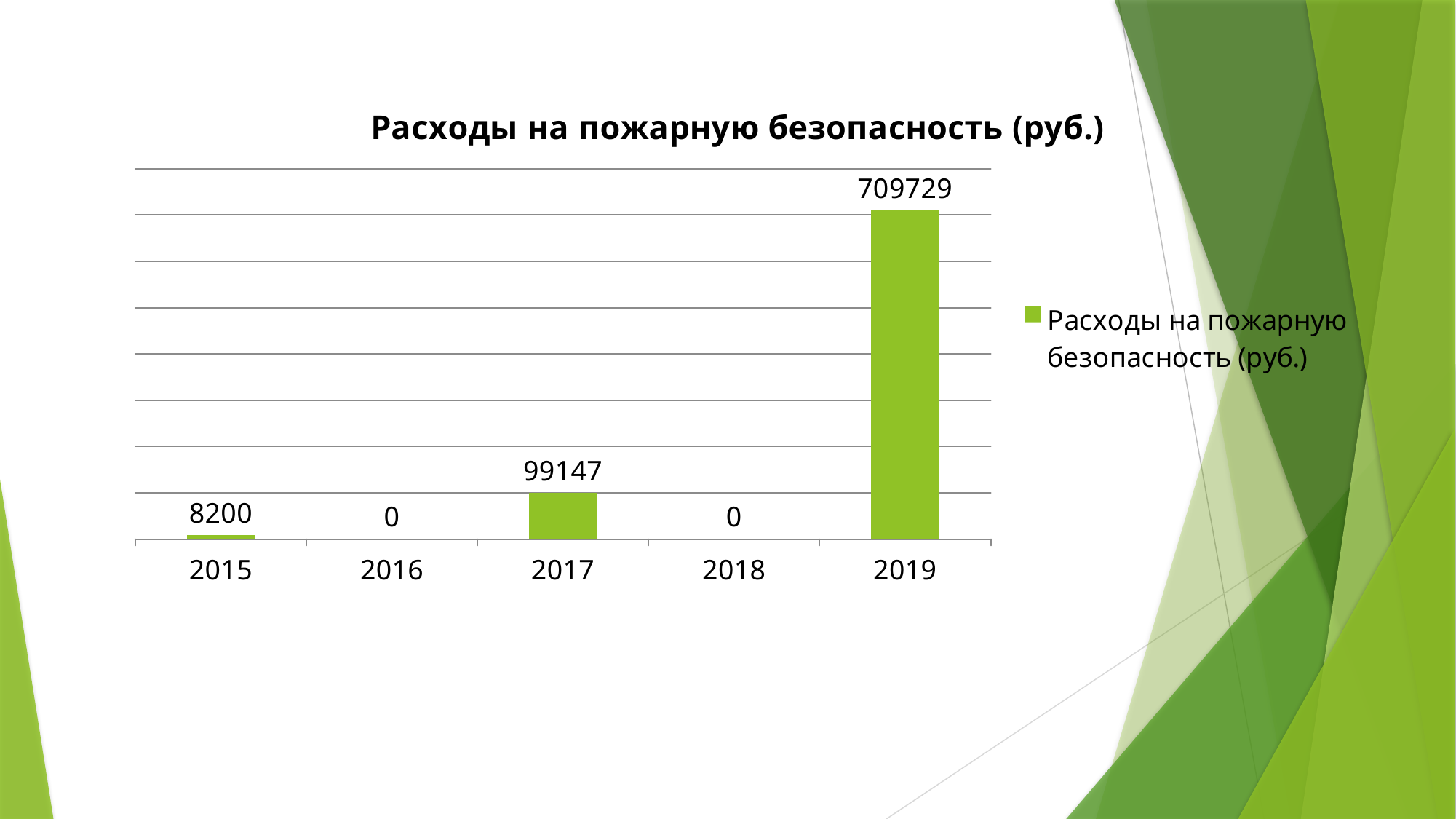
Which year has the highest value? 2019 What kind of chart is shown? bar chart How many years are shown on the x axis? 5 What is the title of the chart? Расходы на пожарную безопасность (руб.) What is the value for 2015? 8200 What is the difference between the values for 2019 and 2017? 610582 Which is larger, the value for 2017 or the value for 2015? 2017 What is the value for 2017? 99147 How many series does the legend list? 1 What is the value for 2016? 0 What is the difference between the values for 2017 and 2015? 90947 What is the value for 2019? 709729